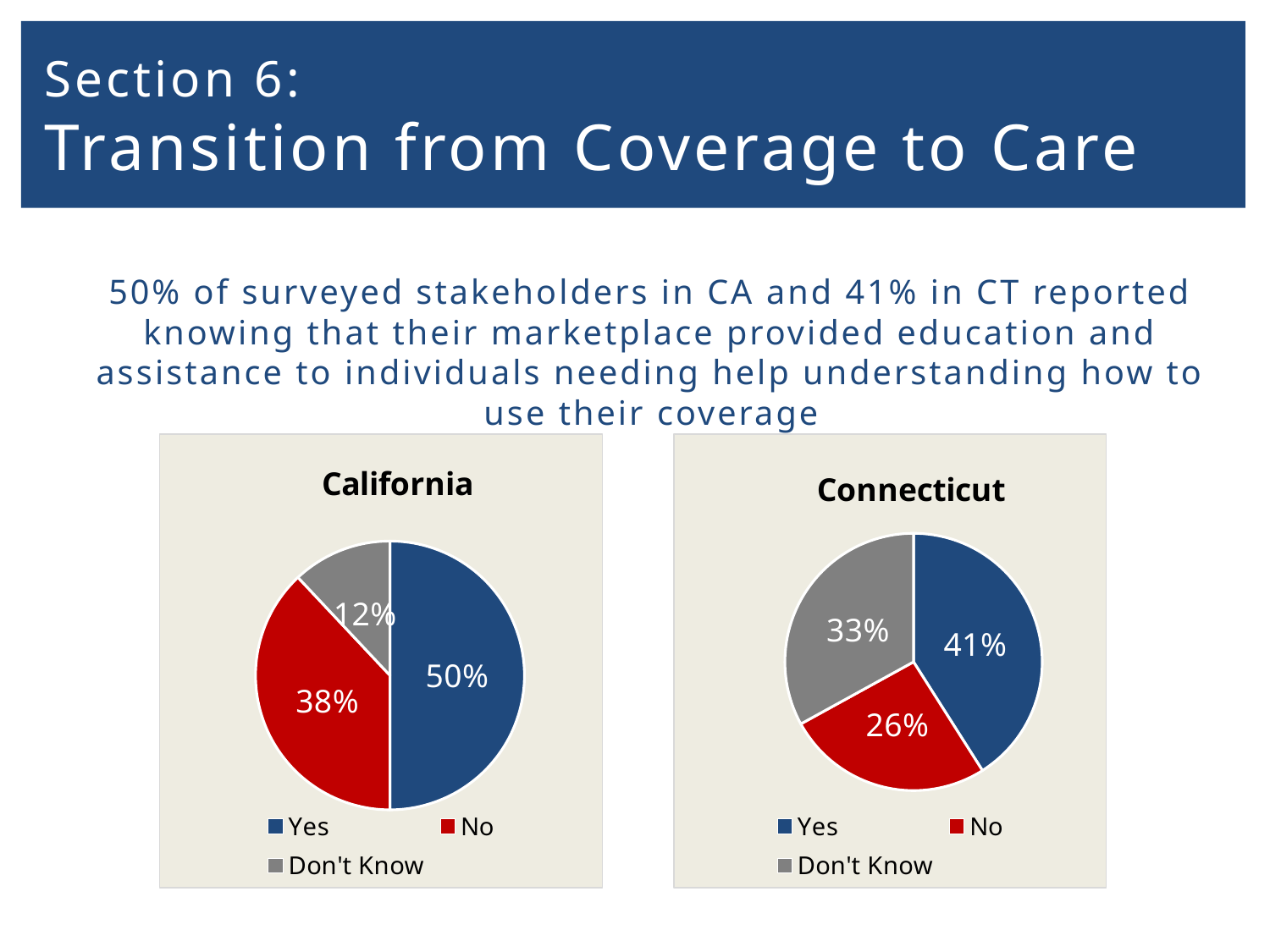
In the California chart, which response has the largest slice? Yes What kind of chart is the Connecticut chart? Pie chart In the California chart, what share of respondents answered Yes? 50% In the Connecticut chart, what share of respondents answered Yes? 41% In the California chart, what is the difference between the Yes and No shares? 12% In the Connecticut chart, which response has the smallest slice? No In the Connecticut chart, which is larger, the Don't Know slice or the No slice? Don't Know In the Connecticut chart, what share of respondents answered No? 26% How many categories does the legend of the California chart list? 3 In the California chart, what share of respondents answered No? 38% In the California chart, what share of respondents answered Don't Know? 12% In the Connecticut chart, what share of respondents answered Don't Know? 33%